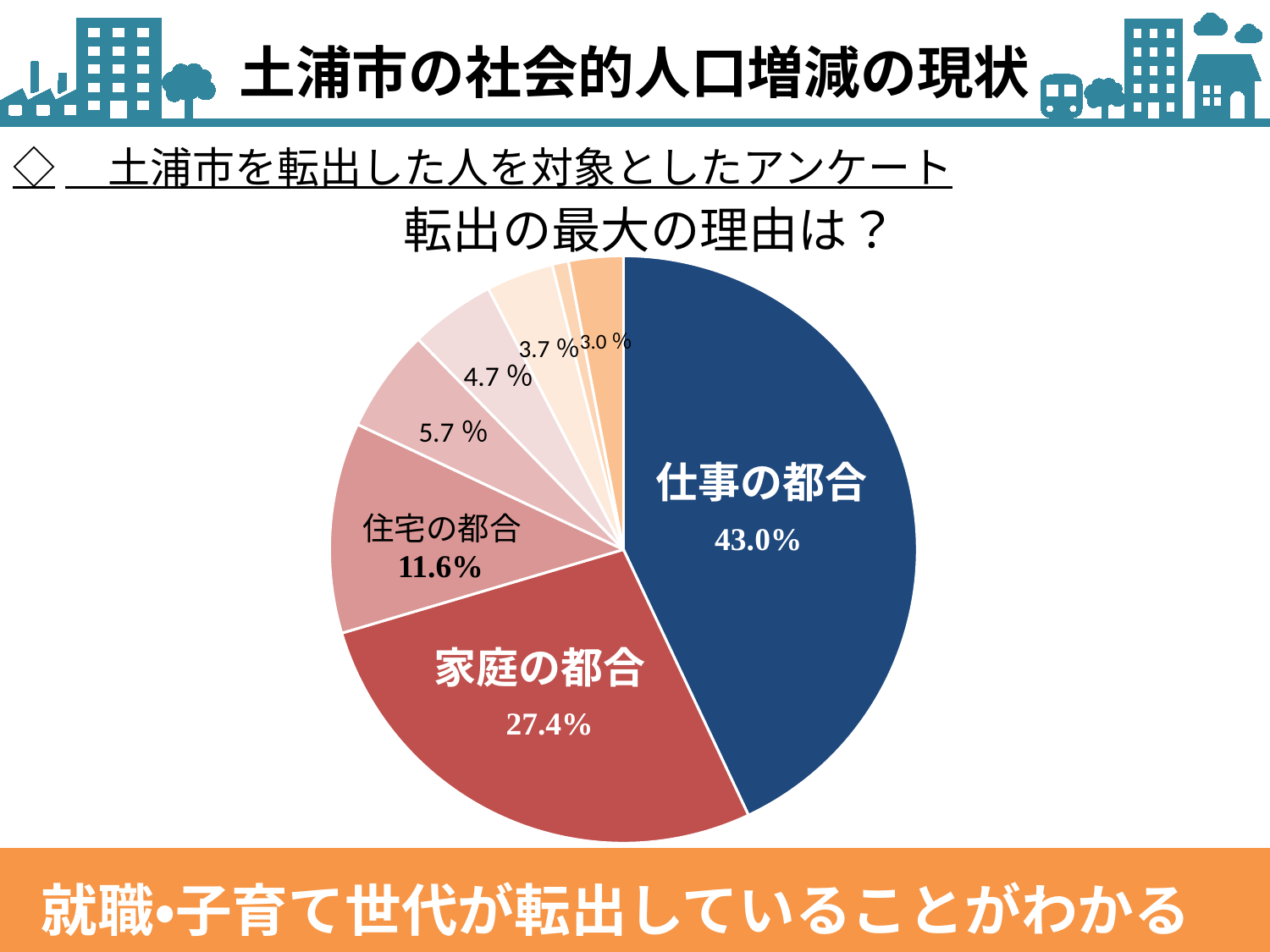
What is the title of the pie chart? 転出の最大の理由は？ What percentage of the pie is 家庭の都合? 27.4% Which reason has the largest share of the pie? 仕事の都合 What percentage of the pie is 住宅の都合? 11.6% What is the difference in percentage points between 家庭の都合 and 住宅の都合? 15.8 What is the combined share of 仕事の都合 and 家庭の都合? 70.4% What is the difference in percentage points between 仕事の都合 and 家庭の都合? 15.6 What type of chart is shown on the slide? pie chart What colour is the 仕事の都合 slice? dark blue What is the difference in percentage points between 仕事の都合 and 住宅の都合? 31.4 What percentage of the pie is 仕事の都合? 43.0% Which is larger, 家庭の都合 or 住宅の都合? 家庭の都合